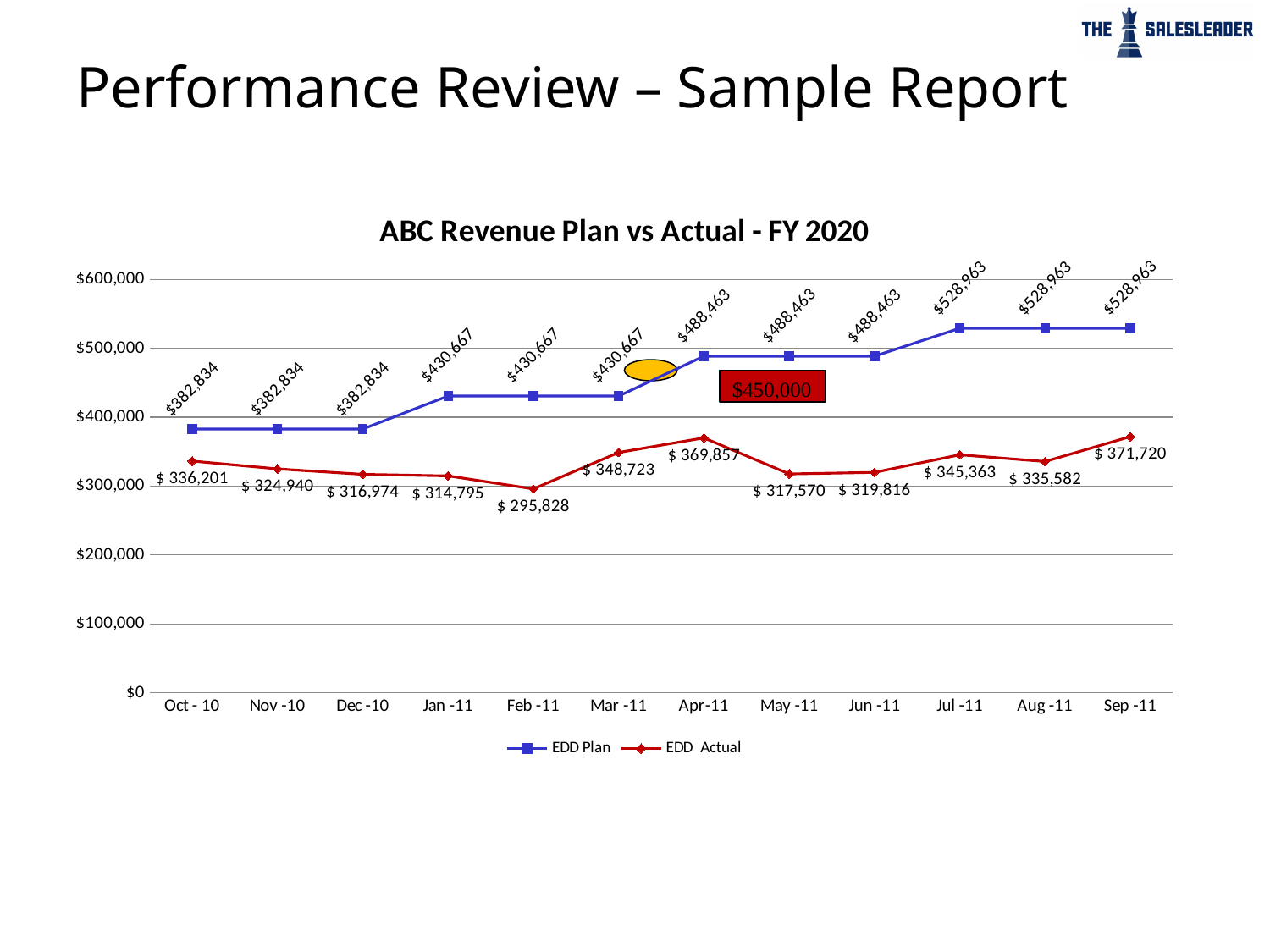
In which month is EDD Actual at its highest? Sep -11 What is the EDD Actual value for Apr-11? $ 369,857 What is the title of the chart? ABC Revenue Plan vs Actual - FY 2020 Is the EDD Plan value for Jul -11 greater or less than $500,000? greater What type of chart is shown on the slide? Line chart Does the EDD Plan line rise or fall from Oct - 10 to Sep -11? Rise What is the difference between EDD Plan and EDD Actual in Sep -11? $157,243 How many series does the legend list? 2 In which month is EDD Actual at its lowest? Feb -11 How many months are plotted along the x axis? 12 What is the EDD Plan value for Jan -11? $430,667 Which is larger in Mar -11, EDD Plan or EDD Actual? EDD Plan